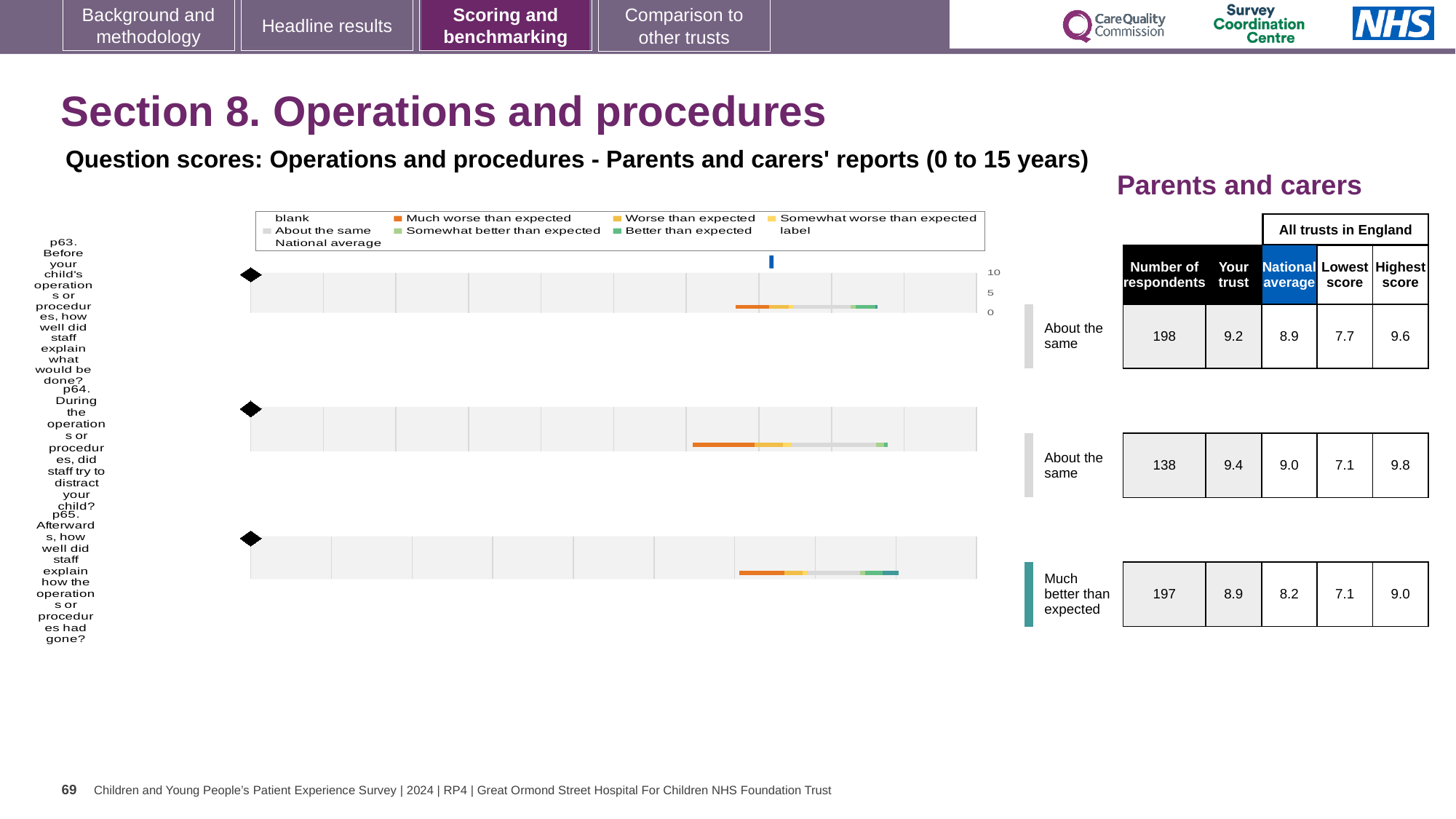
What is the difference between the 'Your trust' score and the national average for p65? 0.7 What is the highest score across all trusts in England for p64? 9.8 Which question has the fewest respondents? p64 What is the lowest score across all trusts in England for p63? 7.7 For p64, which is larger: the 'Your trust' score or the national average? Your trust What benchmark category is shown for p65? Much better than expected How many respondents answered p65 (how well staff explained how the operation had gone)? 197 What is the 'Your trust' score for p63 (how well staff explained what would be done before the operation)? 9.2 How many questions (p63, p64, p65) are plotted on the slide? 3 What kind of chart is used to show the question scores for p63, p64 and p65? bar chart What is the national average score for p64 (did staff try to distract your child during the operation)? 9.0 Which question has the highest 'Your trust' score? p64